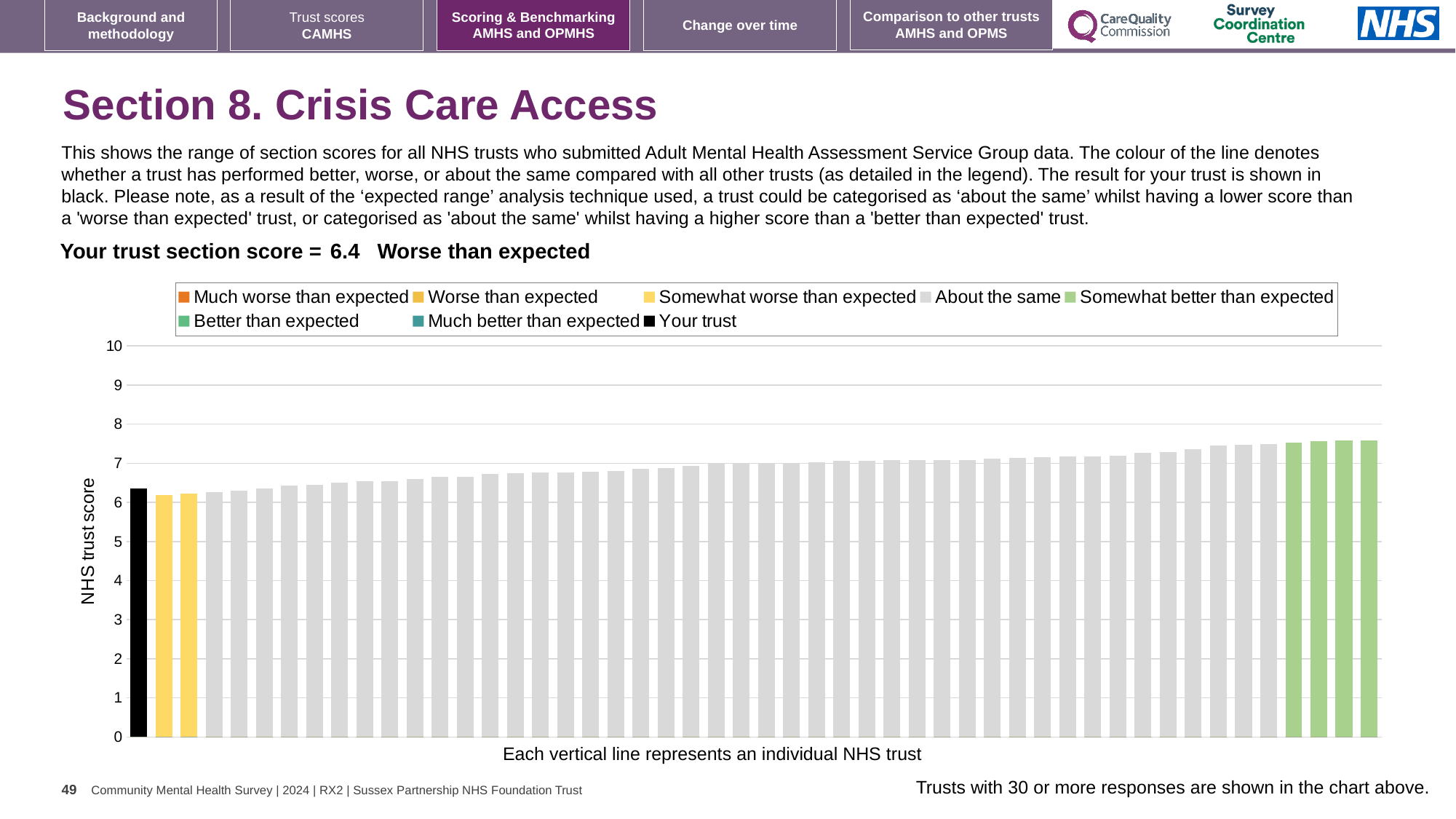
What type of chart is shown on the slide? bar chart How many bars are coloured yellow (somewhat worse than expected)? 2 Is the value of the highest bar in the chart greater or less than 8? less How many bars are coloured green (somewhat better than expected)? 4 Which category is your trust's section score placed in? Worse than expected Do the bar values rise or fall from left to right along the x axis? rise (after the black 'Your trust' bar, which is placed first) Is the value for your trust greater or less than 7? less What is the label on the vertical axis of the chart? NHS trust score Is the value of the highest bar in the chart greater or less than 7? greater How many entries does the chart legend list? 8 What is the section score for your trust shown on the slide? 6.4